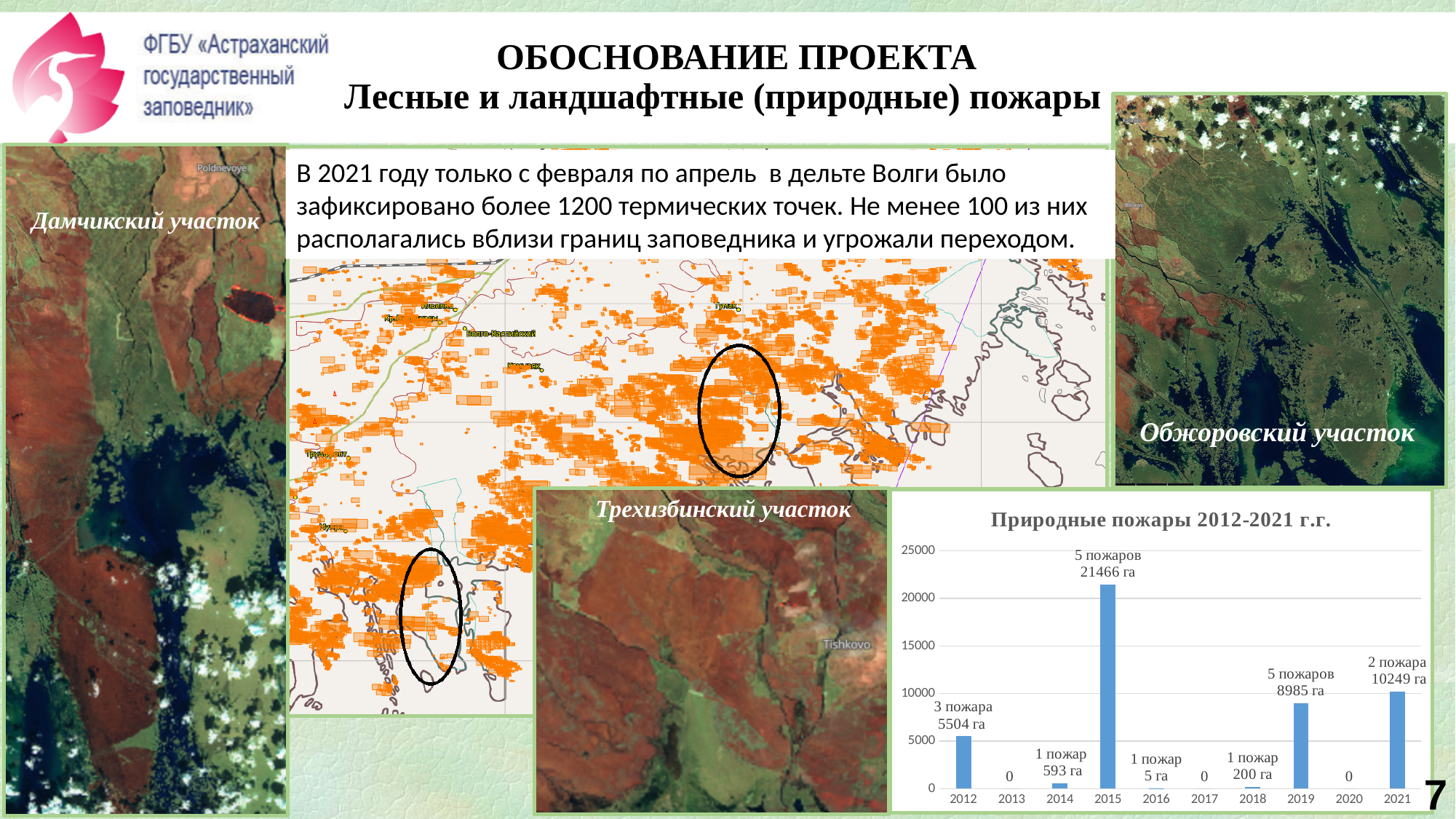
What is the title of the bar chart on the slide? Природные пожары 2012-2021 г.г. What type of chart is shown under the title "Природные пожары 2012-2021 г.г."? bar chart In the chart "Природные пожары 2012-2021 г.г.", which year has the highest bar? 2015 In the chart "Природные пожары 2012-2021 г.г.", what value is shown for 2013? 0 In the chart "Природные пожары 2012-2021 г.г.", how many years are shown on the x axis? 10 In the chart "Природные пожары 2012-2021 г.г.", what area (in га) is labelled for 2015? 21466 га In the chart "Природные пожары 2012-2021 г.г.", is the value for 2021 greater or less than 10000? greater In the chart "Природные пожары 2012-2021 г.г.", which year has the larger burned area, 2019 or 2012? 2019 In the chart "Природные пожары 2012-2021 г.г.", what is the difference in area between 2015 (21466 га) and 2021 (10249 га)? 11217 га In the chart "Природные пожары 2012-2021 г.г.", what area is labelled for 2021? 10249 га In the chart "Природные пожары 2012-2021 г.г.", how many fires are labelled for 2019? 5 пожаров In the chart "Природные пожары 2012-2021 г.г.", how many years show a value of 0? 3